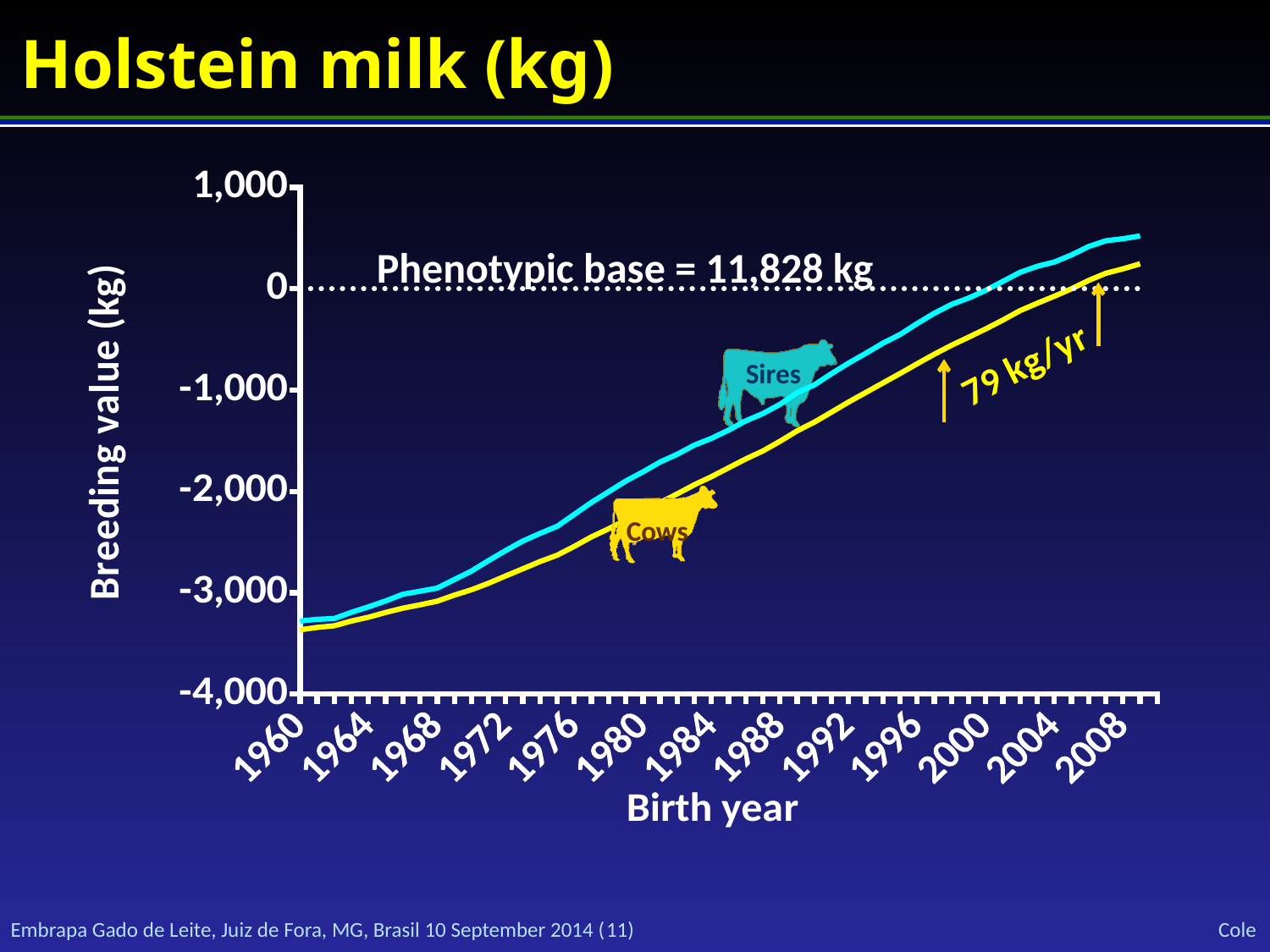
What kind of chart is shown on the slide? line chart Which series has the lower breeding value in 1972, Sires or Cows? Cows Which two series are plotted in the chart? Sires and Cows Is the breeding value for Sires in 2008 greater or less than 0? greater Is the breeding value for Cows in 1976 greater or less than -2,000? less Which series has the higher breeding value in 1984, Sires or Cows? Sires How many series are plotted in the chart? 3 Is the breeding value for Sires in 1988 greater or less than -1,000? less What is the phenotypic base value stated on the chart? 11,828 kg Do the breeding values rise or fall as birth year increases? rise